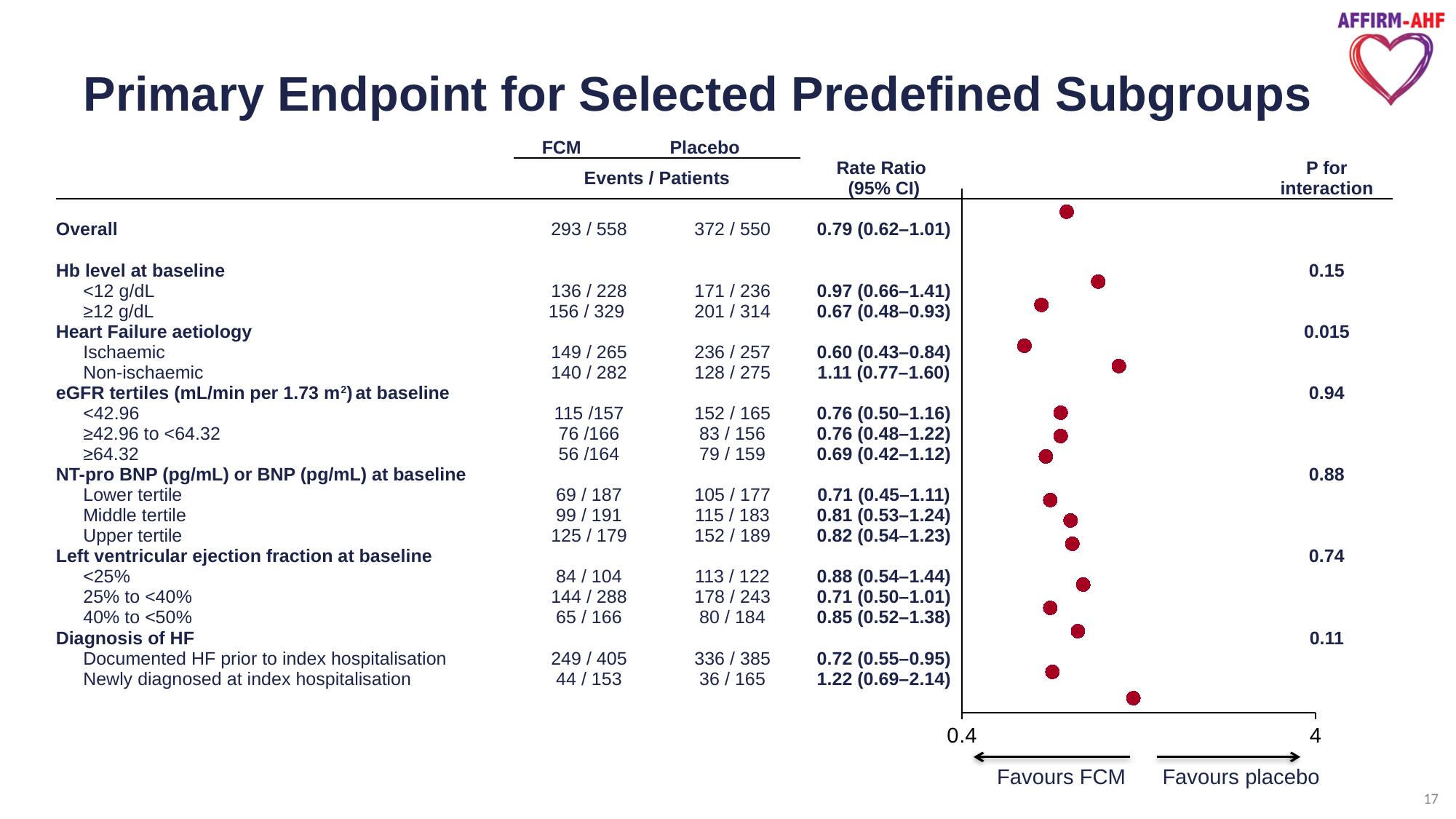
What kind of chart is shown on the slide? Forest plot What is the rate ratio (95% CI) for the Ischaemic subgroup? 0.60 (0.43–0.84) Which subgroup has the lowest rate ratio? Ischaemic Which has the larger rate ratio, Ischaemic or Non-ischaemic? Non-ischaemic What is the difference between the rate ratios for Non-ischaemic and Ischaemic? 0.51 Which subgroup has the highest rate ratio? Newly diagnosed at index hospitalisation What is the P for interaction for Heart Failure aetiology? 0.015 What is the rate ratio (95% CI) for the Overall group? 0.79 (0.62–1.01) How many rate ratio points are plotted in the chart? 16 What is the rate ratio (95% CI) for the Hb level <12 g/dL subgroup? 0.97 (0.66–1.41) Which has the larger rate ratio, Hb <12 g/dL or Hb ≥12 g/dL? <12 g/dL What do the two ends of the x axis favour, according to the labels below the axis? Favours FCM (left) and Favours placebo (right)